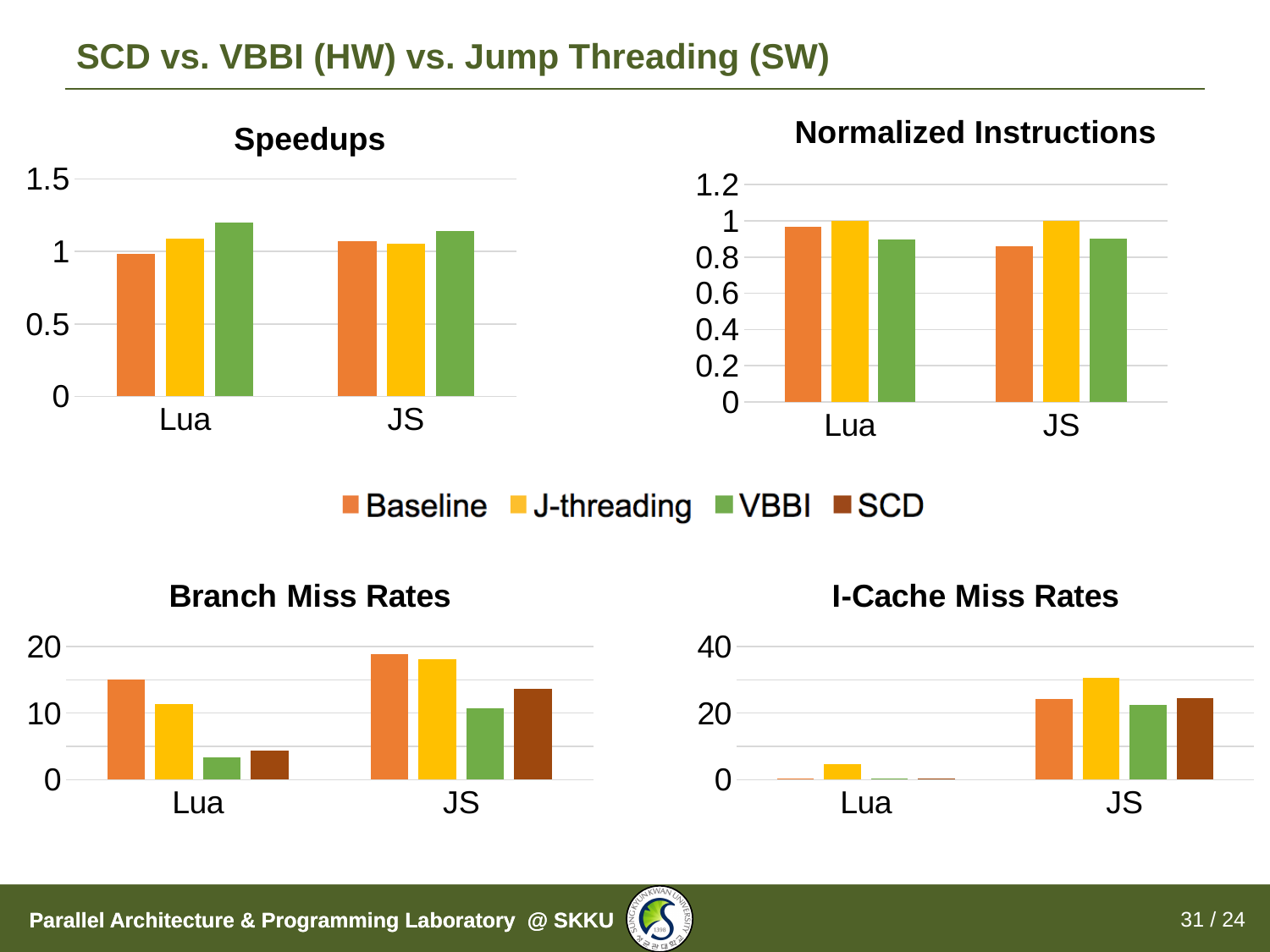
In the Speedups chart, which series has the highest value for Lua? VBBI In the Branch Miss Rates chart, which series has the lowest value for Lua? VBBI What kind of chart is the Speedups chart? bar chart In the Speedups chart, which series has the lowest value for Lua? Baseline In the I-Cache Miss Rates chart, is the J-threading value for JS greater or less than 20? greater In the Branch Miss Rates chart, is the Baseline value for Lua greater or less than 10? greater How many series does the shared legend list? 4 In the Speedups chart, is the VBBI value for Lua greater or less than 1? greater In the Normalized Instructions chart, which series has the highest value for JS? J-threading In the I-Cache Miss Rates chart, which series has the highest value for JS? J-threading In the Speedups chart, how many categories are shown on the x axis? 2